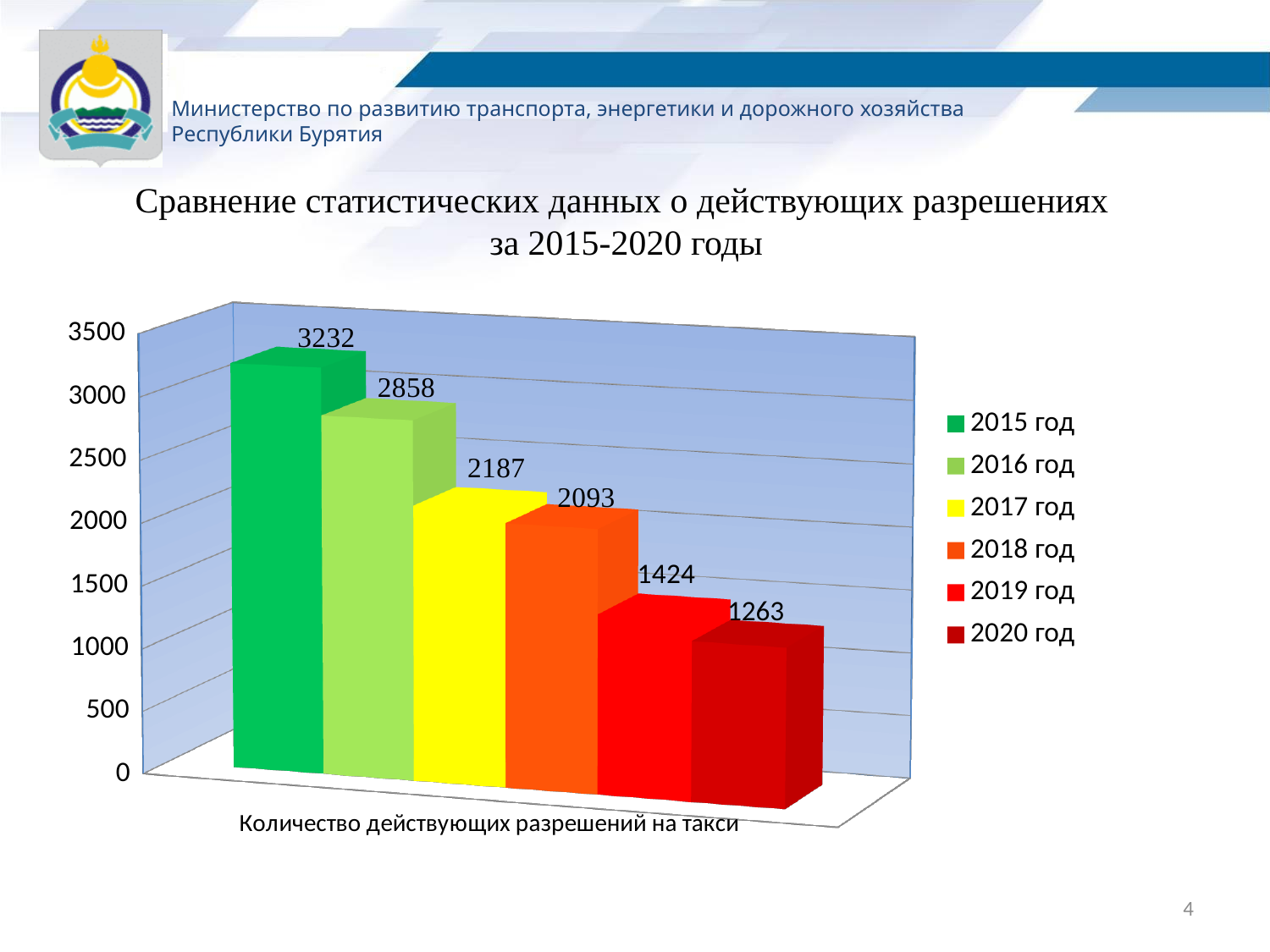
What is the difference between the values for 2015 год and 2016 год? 374 How many series does the legend list? 6 What is the value for 2020 год? 1263 What is the difference between the values for 2019 год and 2020 год? 161 Which is larger, the value for 2017 год or the value for 2019 год? 2017 год What kind of chart is shown on the slide? bar chart Which year has the lowest value? 2020 год What is the label shown below the bars on the x axis? Количество действующих разрешений на такси Do the values rise or fall from 2015 год to 2020 год? fall What is the value for 2015 год? 3232 Which year has the highest value? 2015 год What is the value for 2018 год? 2093